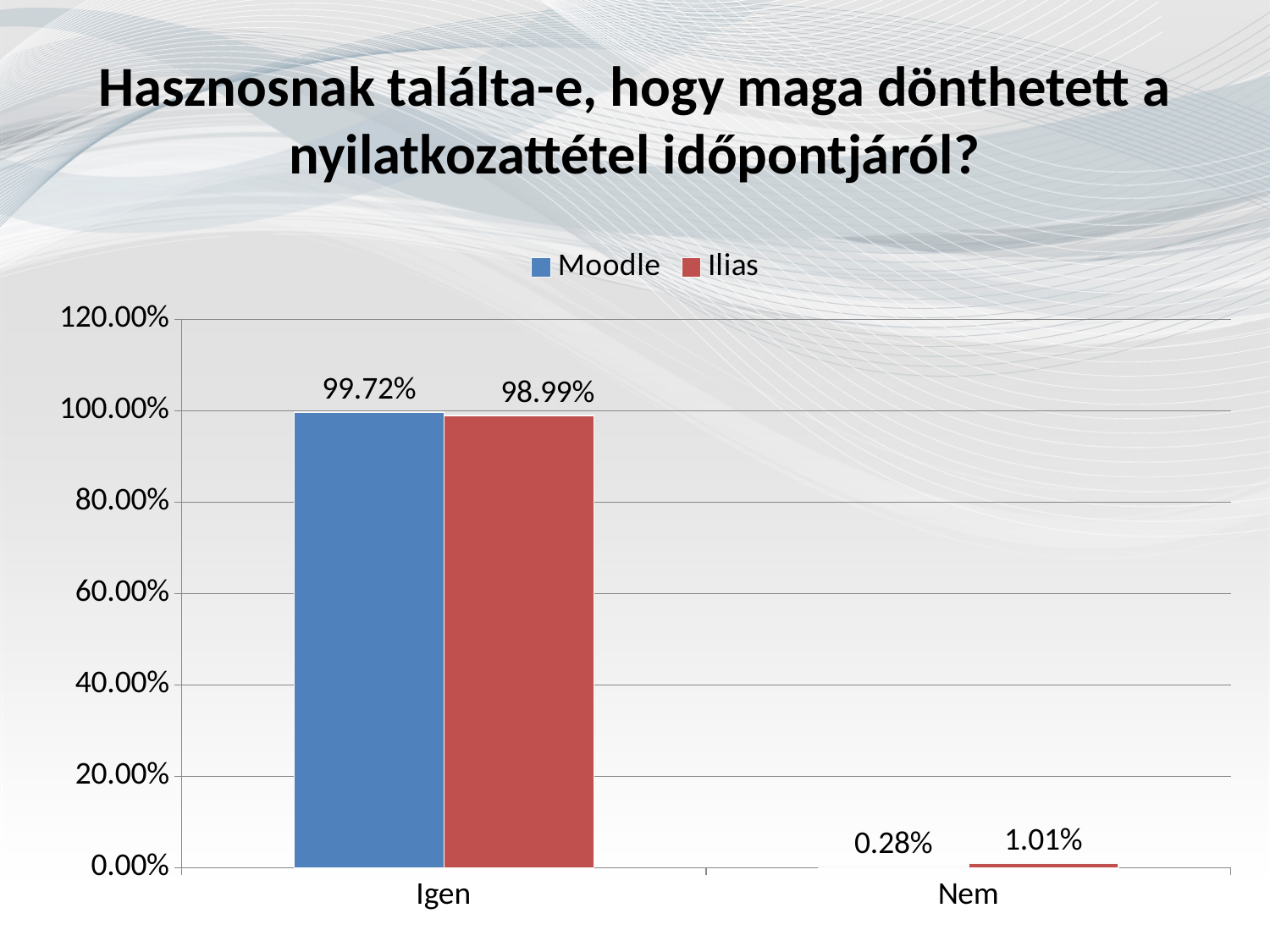
What is the value for Ilias in the Nem category? 1.01% What is the difference between the Ilias and Moodle values in the Nem category? 0.73% What is the difference between the Moodle and Ilias values in the Igen category? 0.73% Which series has the higher value in the Nem category, Moodle or Ilias? Ilias Which series has the higher value in the Igen category, Moodle or Ilias? Moodle What kind of chart is shown on the slide? Bar chart What is the value for Ilias in the Igen category? 98.99% How many categories are shown on the x axis? 2 What is the value for Moodle in the Nem category? 0.28% What is the value for Moodle in the Igen category? 99.72% Which category has the lowest value for Moodle? Nem How many series does the legend list? 2